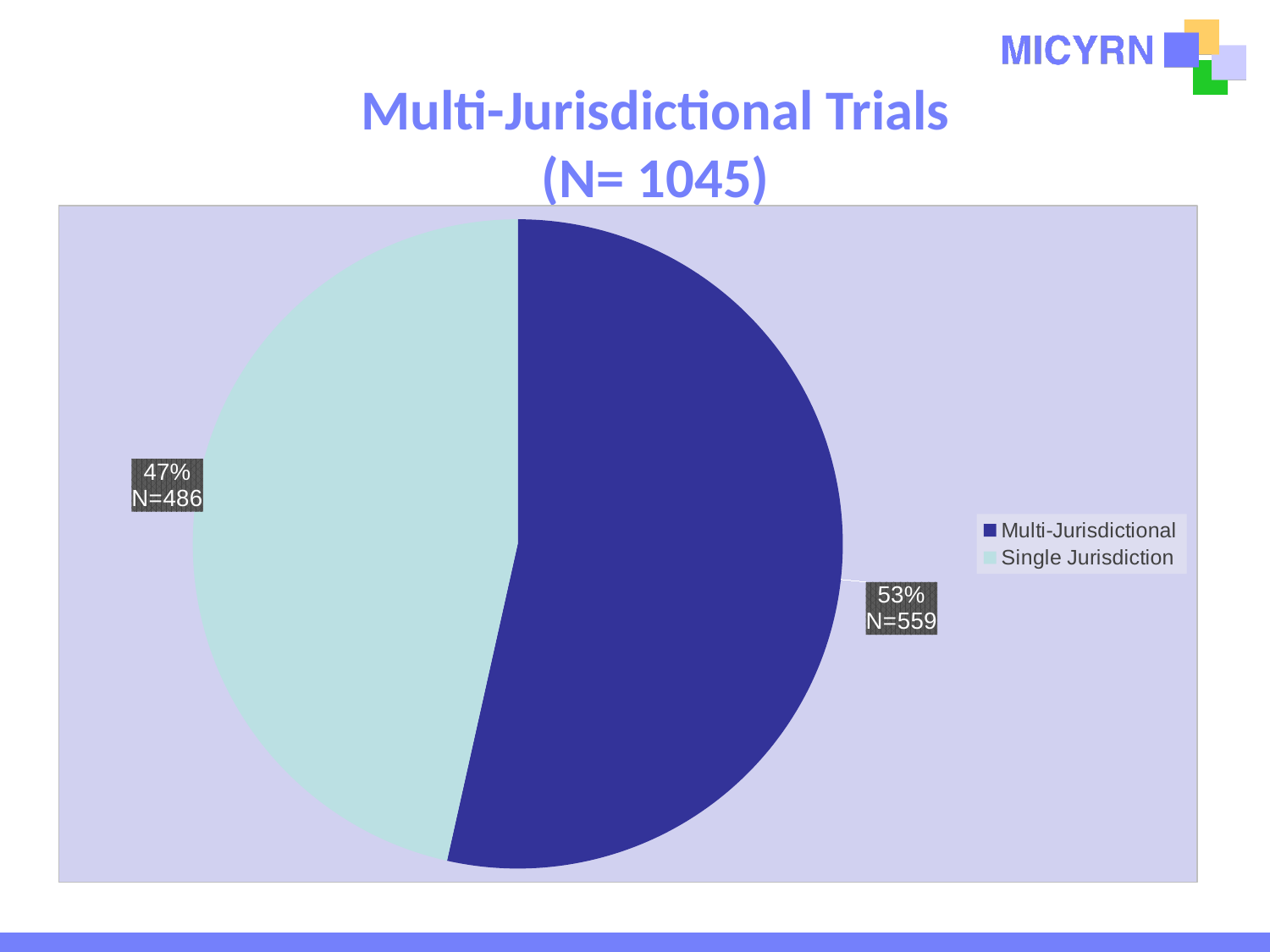
Which category has the smaller share of the pie? Single Jurisdiction What kind of chart is shown on the slide? pie chart How many trials are Multi-Jurisdictional (N)? N=559 What percentage of trials are Single Jurisdiction? 47% What percentage of trials are Multi-Jurisdictional? 53% How many slices does the pie chart have? 2 What is the difference in percentage points between Multi-Jurisdictional and Single Jurisdiction? 6 Which category has the larger share of the pie? Multi-Jurisdictional What is the total N shown in the chart title? 1045 What is the difference in the number of trials between Multi-Jurisdictional and Single Jurisdiction? 73 What is the title of the chart? Multi-Jurisdictional Trials (N= 1045) How many trials are Single Jurisdiction (N)? N=486